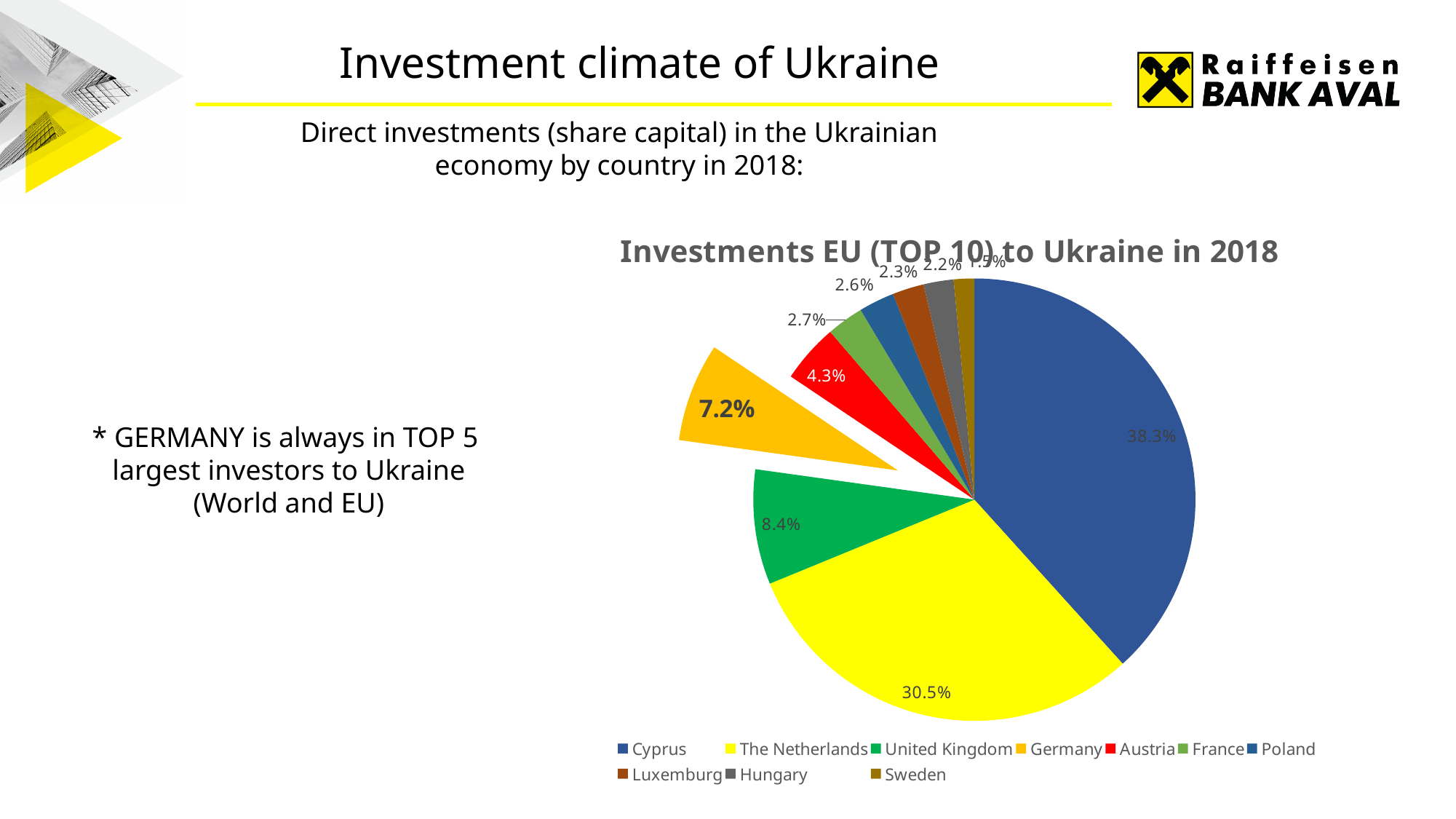
What is the value shown for Germany? 7.2% What type of chart is shown on the slide? pie chart What is the title of the chart? Investments EU (TOP 10) to Ukraine in 2018 What is the difference between the shares of Cyprus and The Netherlands? 7.8% What share of the pie does Cyprus hold? 38.3% What is the value shown for the United Kingdom? 8.4% What is the value shown for Austria? 4.3% How many countries are listed in the chart legend? 10 Which country has the largest share of the pie? Cyprus Which slice of the pie is pulled out (exploded) from the rest? Germany What share of the pie does The Netherlands hold? 30.5% Which is larger, the share for the United Kingdom or the share for Germany? United Kingdom